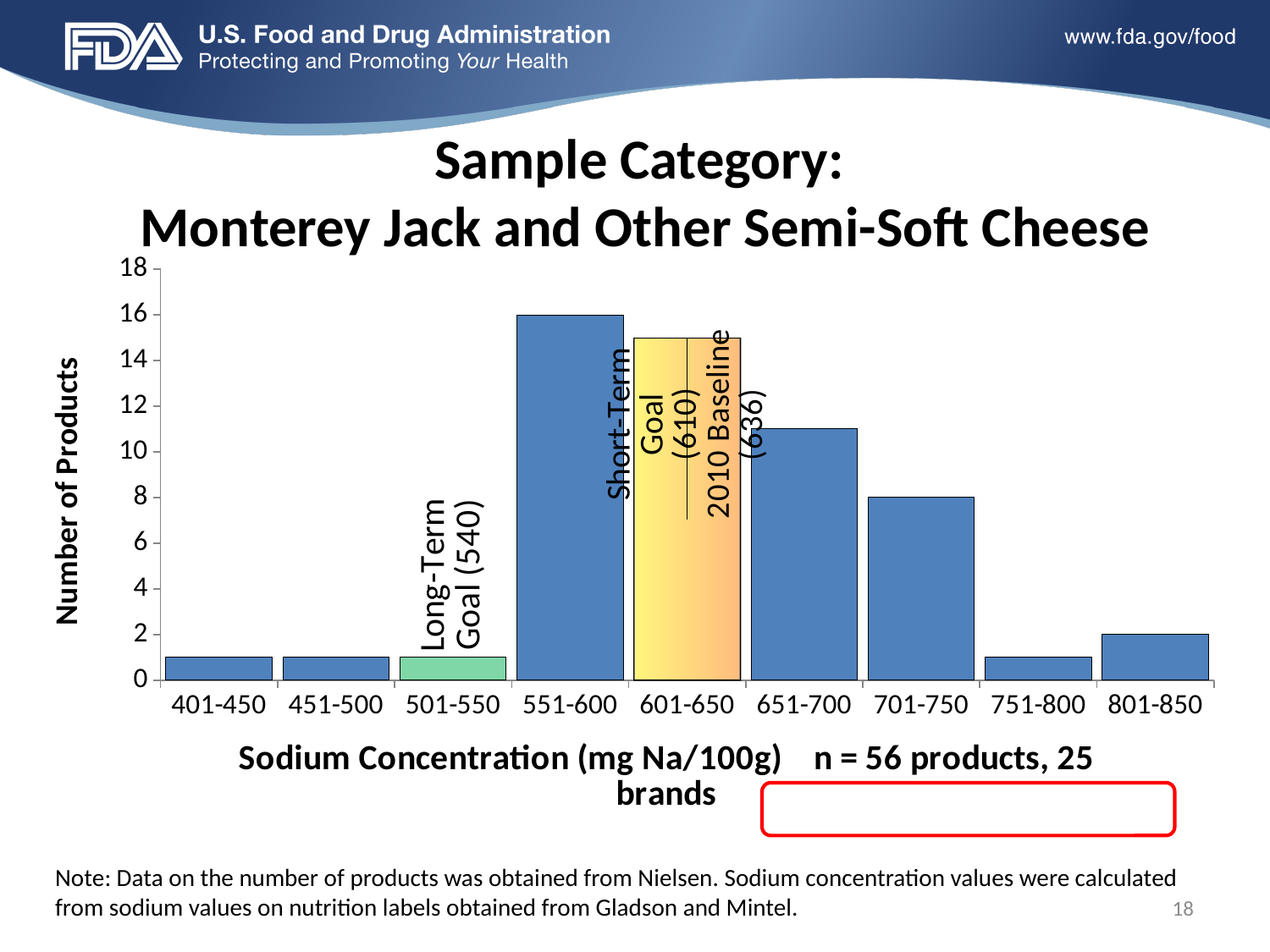
Is the number of products in the 651-700 category greater or less than 10? greater How many products are in the 701-750 mg Na/100g category? 8 Which category has more products, 551-600 or 701-750? 551-600 How many products are in the 551-600 mg Na/100g category? 16 What sodium value is given for the Long-Term Goal annotation on the chart? 540 How many products are in the 801-850 mg Na/100g category? 2 Is the number of products in the 401-450 category greater or less than 2? less Is the number of products in the 601-650 category greater or less than 14? greater Which sodium concentration category has the highest number of products? 551-600 What kind of chart is shown on the slide? bar chart What is the difference in the number of products between the 551-600 and 701-750 categories? 8 How many sodium concentration categories are shown on the x axis? 9